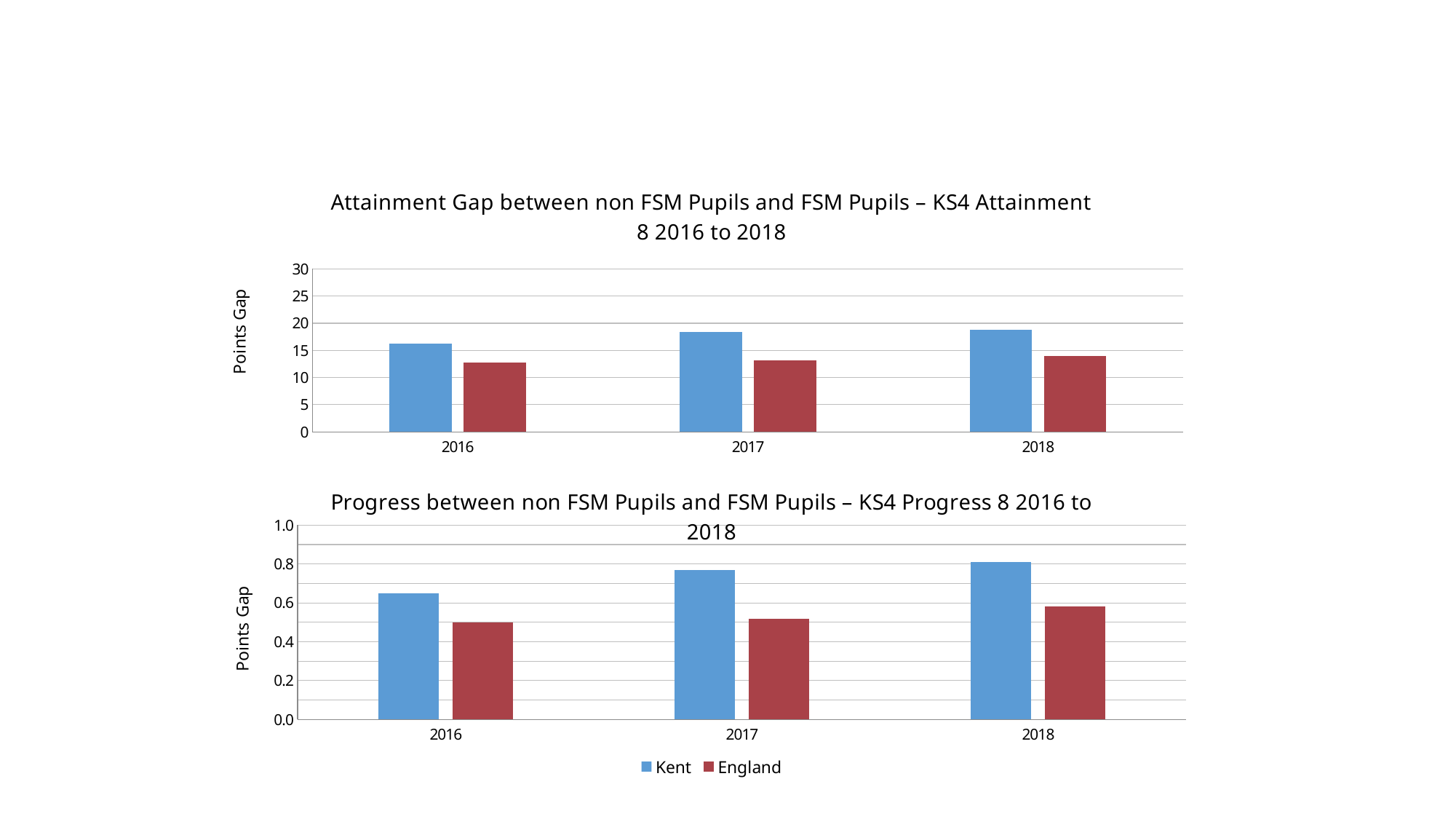
How many years are shown on the x axis of the top chart? 3 In the top chart (KS4 Attainment 8), is the value for England in 2016 greater or less than 15? less In the top chart (KS4 Attainment 8), is the value for Kent in 2018 greater or less than 20? less In the top chart (KS4 Attainment 8), which is larger in 2017, Kent or England? Kent In the top chart (KS4 Attainment 8), is the value for Kent in 2016 greater or less than 15? greater In the bottom chart (KS4 Progress 8), do the Kent values rise or fall from 2016 to 2018? rise What kind of chart is the top chart titled 'Attainment Gap between non FSM Pupils and FSM Pupils – KS4 Attainment 8 2016 to 2018'? bar chart How many series does the legend list for the bottom chart? 2 What is the y-axis label of the top chart? Points Gap In the bottom chart (KS4 Progress 8), which is larger in 2018, Kent or England? Kent